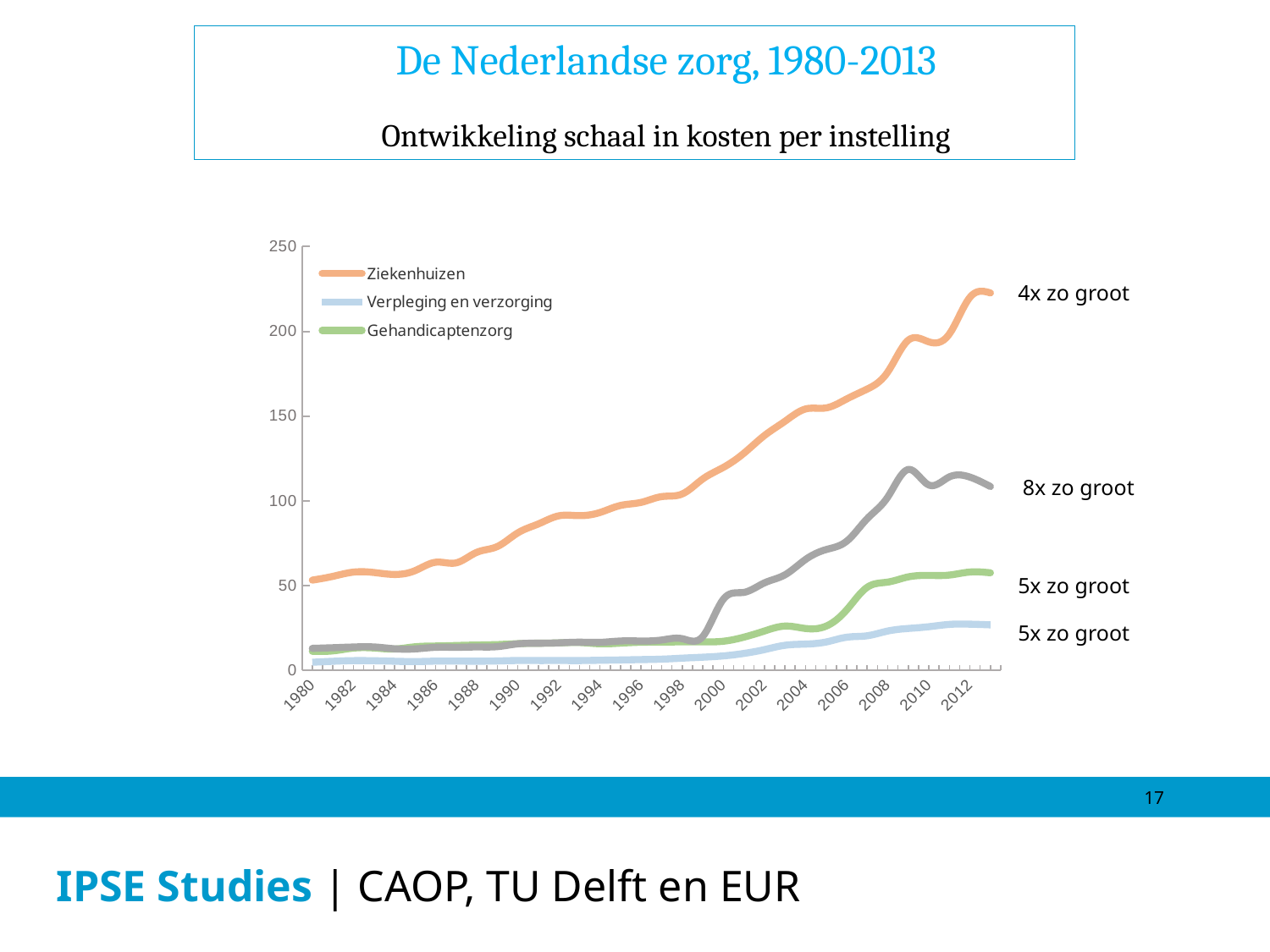
Is the value for Gehandicaptenzorg in 1980 greater or less than 50? less Is the value for Ziekenhuizen in 1980 greater or less than 100? less Is the value for Verpleging en verzorging in 2012 greater or less than 50? less Does the Ziekenhuizen line rise or fall from 1980 to 2012? rise How many series does the legend list? 3 Which series is lowest at the right end of the chart (2012)? Verpleging en verzorging Which series is highest at the right end of the chart (2012)? Ziekenhuizen Which is larger in 2012, the value for Ziekenhuizen or the value for Gehandicaptenzorg? Ziekenhuizen What is the subtitle of the chart shown on the slide? Ontwikkeling schaal in kosten per instelling What kind of chart is shown on the slide? line chart What annotation is written next to the end of the Ziekenhuizen line? 4x zo groot